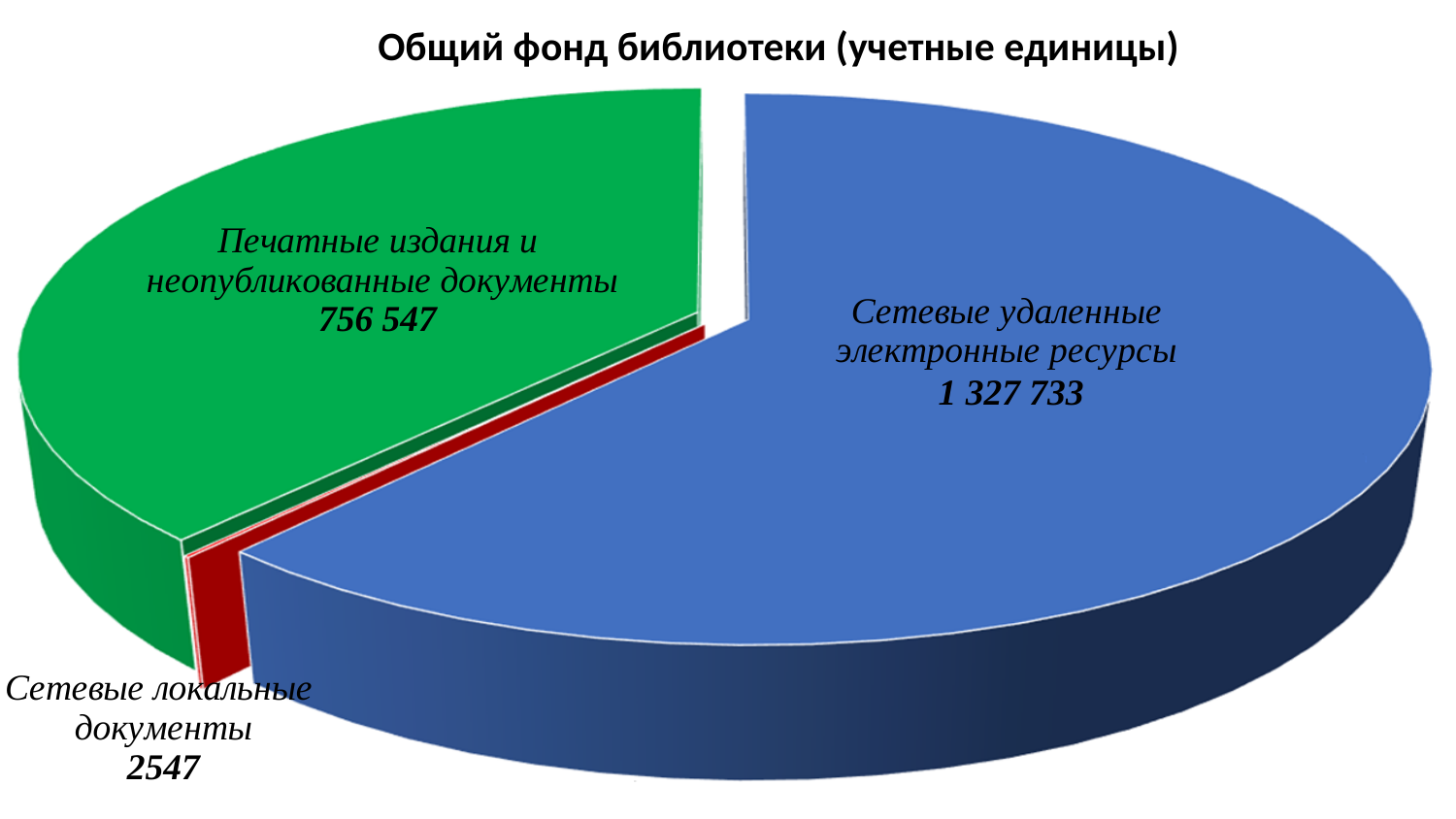
What is the value for Сетевые локальные документы? 2547 What is the value for Печатные издания и неопубликованные документы? 756 547 Which category has the largest slice of the pie? Сетевые удаленные электронные ресурсы Which category has the smallest slice of the pie? Сетевые локальные документы What type of chart is shown on the slide? Pie chart What colour is the slice for Сетевые локальные документы? Red What is the title of the chart? Общий фонд библиотеки (учетные единицы) How many slices does the pie chart have? 3 What is the total of all three slices in the pie chart? 2 086 827 Which is larger: Печатные издания и неопубликованные документы or Сетевые локальные документы? Печатные издания и неопубликованные документы What is the value for Сетевые удаленные электронные ресурсы? 1 327 733 What is the difference between the values for Сетевые удаленные электронные ресурсы and Печатные издания и неопубликованные документы? 571 186